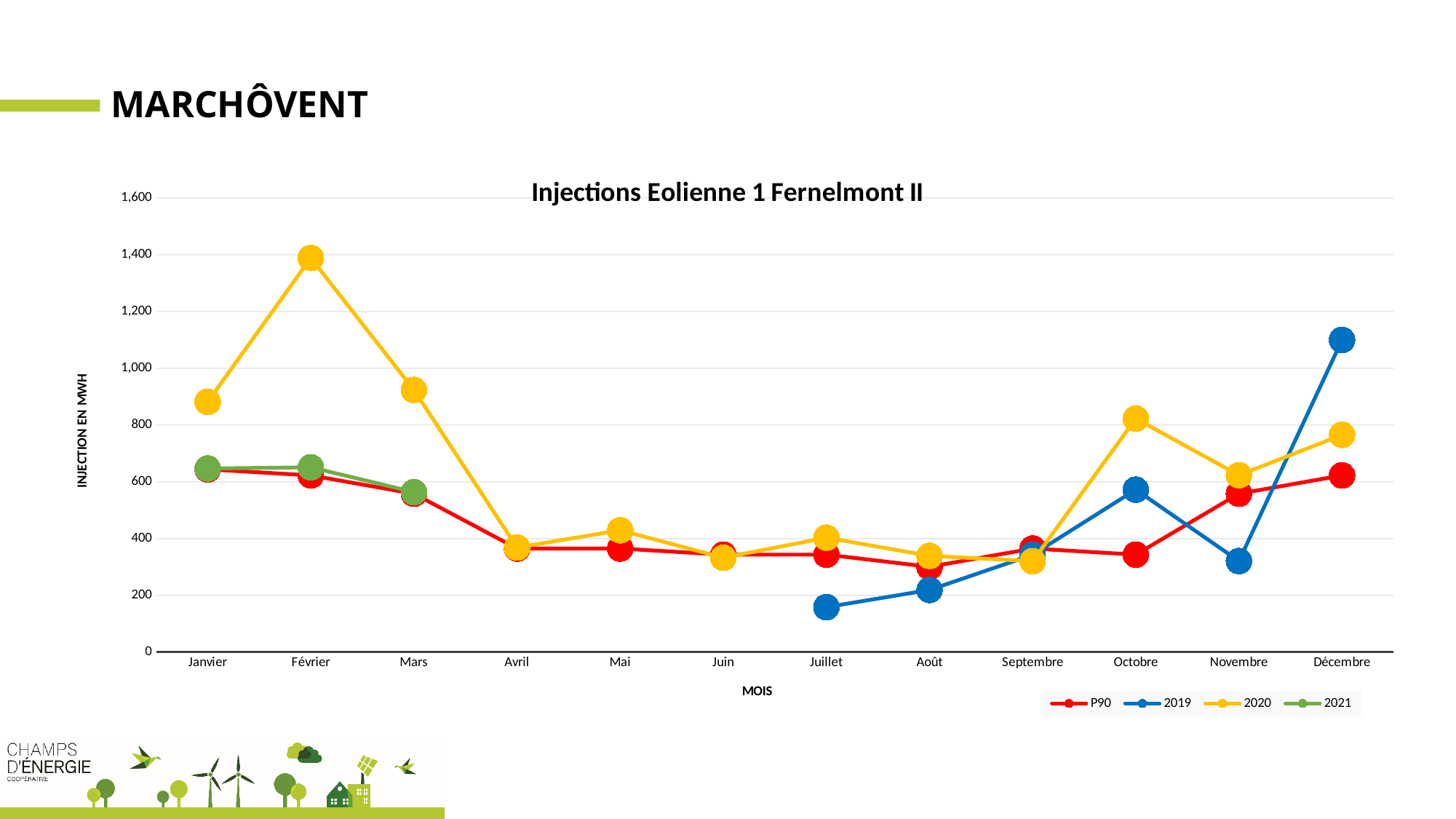
How many series does the legend list? 4 In which month does the 2020 series reach its highest value? Février Is the 2019 value for Juillet greater or less than 200? less What kind of chart is shown on the slide? line chart Does the 2020 series rise or fall from Février to Avril? fall How many months are shown on the x axis? 12 Is the 2020 value for Février greater or less than 1,200? greater What is the title of the chart? Injections Eolienne 1 Fernelmont II In Octobre, which series has the larger value, 2020 or P90? 2020 In Décembre, which series has the larger value, 2019 or 2020? 2019 In which month does the 2019 series have its lowest value? Juillet Is the 2019 value for Décembre greater or less than 1,000? greater